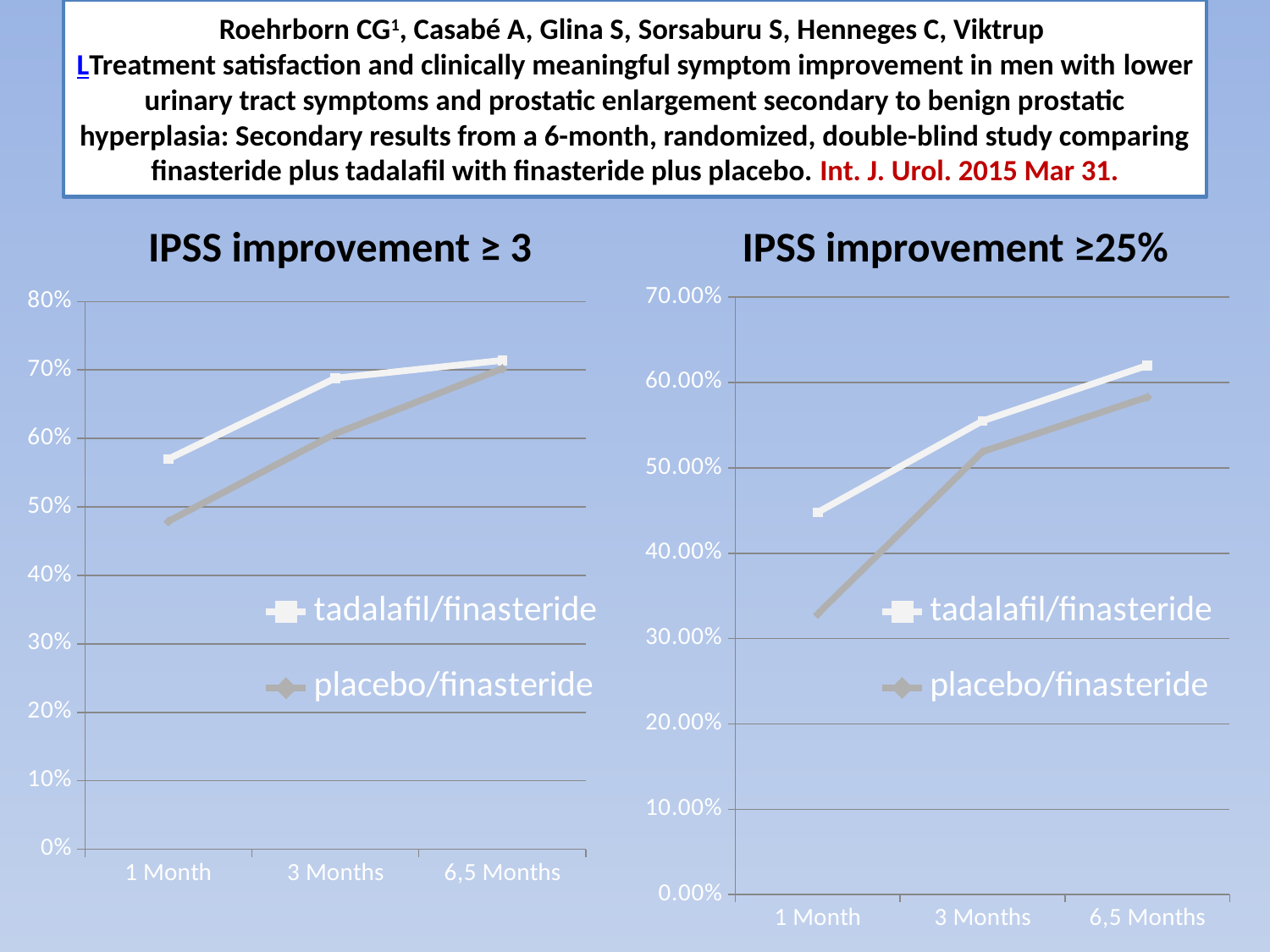
In the 'IPSS improvement ≥25%' chart, do the values for placebo/finasteride rise or fall from 1 Month to 6,5 Months? rise In the 'IPSS improvement ≥ 3' chart, is the value for placebo/finasteride at 1 Month greater or less than 60%? less In the 'IPSS improvement ≥25%' chart, is the value for placebo/finasteride at 1 Month greater or less than 40.00%? less What is the title of the chart on the right side of the slide? IPSS improvement ≥25% In the 'IPSS improvement ≥ 3' chart, is the value for tadalafil/finasteride at 1 Month greater or less than 50%? greater How many time points are plotted on the x axis of the 'IPSS improvement ≥ 3' chart? 3 What kind of chart is the 'IPSS improvement ≥ 3' chart? line chart In the 'IPSS improvement ≥25%' chart, which series has the lower value at 1 Month? placebo/finasteride How many series does the legend of the 'IPSS improvement ≥25%' chart list? 2 In the 'IPSS improvement ≥ 3' chart, at which time point is the tadalafil/finasteride value lowest? 1 Month In the 'IPSS improvement ≥ 3' chart, which series has the higher value at 1 Month? tadalafil/finasteride